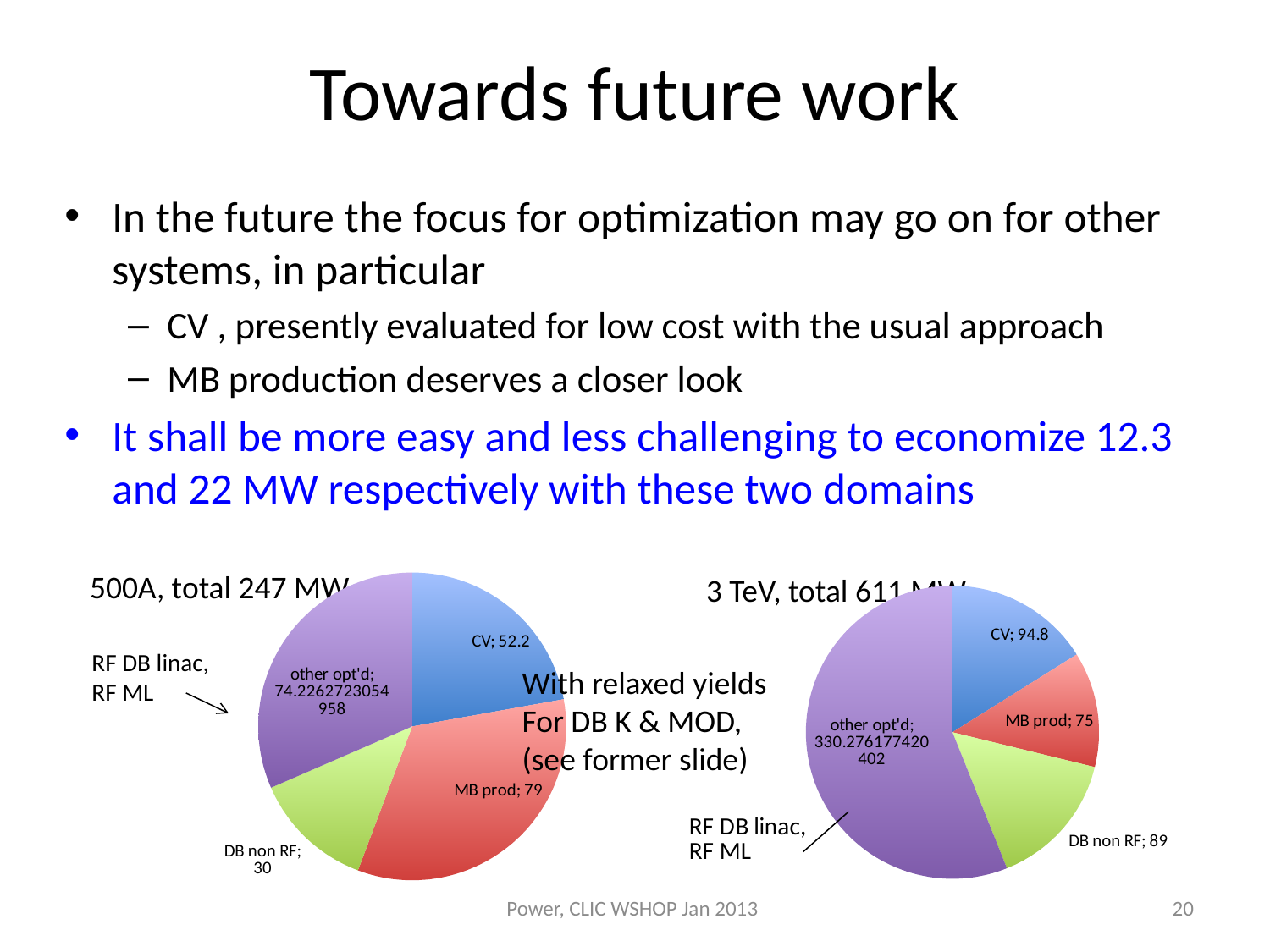
In the left pie chart (500A, total 247 MW), what is the value for CV? 52.2 In the right pie chart (3 TeV, total 611 MW), which slice is the largest? other opt'd In the right pie chart (3 TeV, total 611 MW), what is the value for MB prod? 75 In the left pie chart (500A, total 247 MW), what is the difference between MB prod and CV? 26.8 How many slices does the left pie chart (500A, total 247 MW) have? 4 In the left pie chart (500A, total 247 MW), which slice is the smallest? DB non RF In the left pie chart (500A, total 247 MW), what is the value for DB non RF? 30 In the right pie chart (3 TeV, total 611 MW), which is larger, CV or MB prod? CV In the right pie chart (3 TeV, total 611 MW), what is the value for DB non RF? 89 In the right pie chart (3 TeV, total 611 MW), what is the value for CV? 94.8 In the left pie chart (500A, total 247 MW), what is the value for MB prod? 79 In the right pie chart (3 TeV, total 611 MW), what is the difference between DB non RF and MB prod? 14